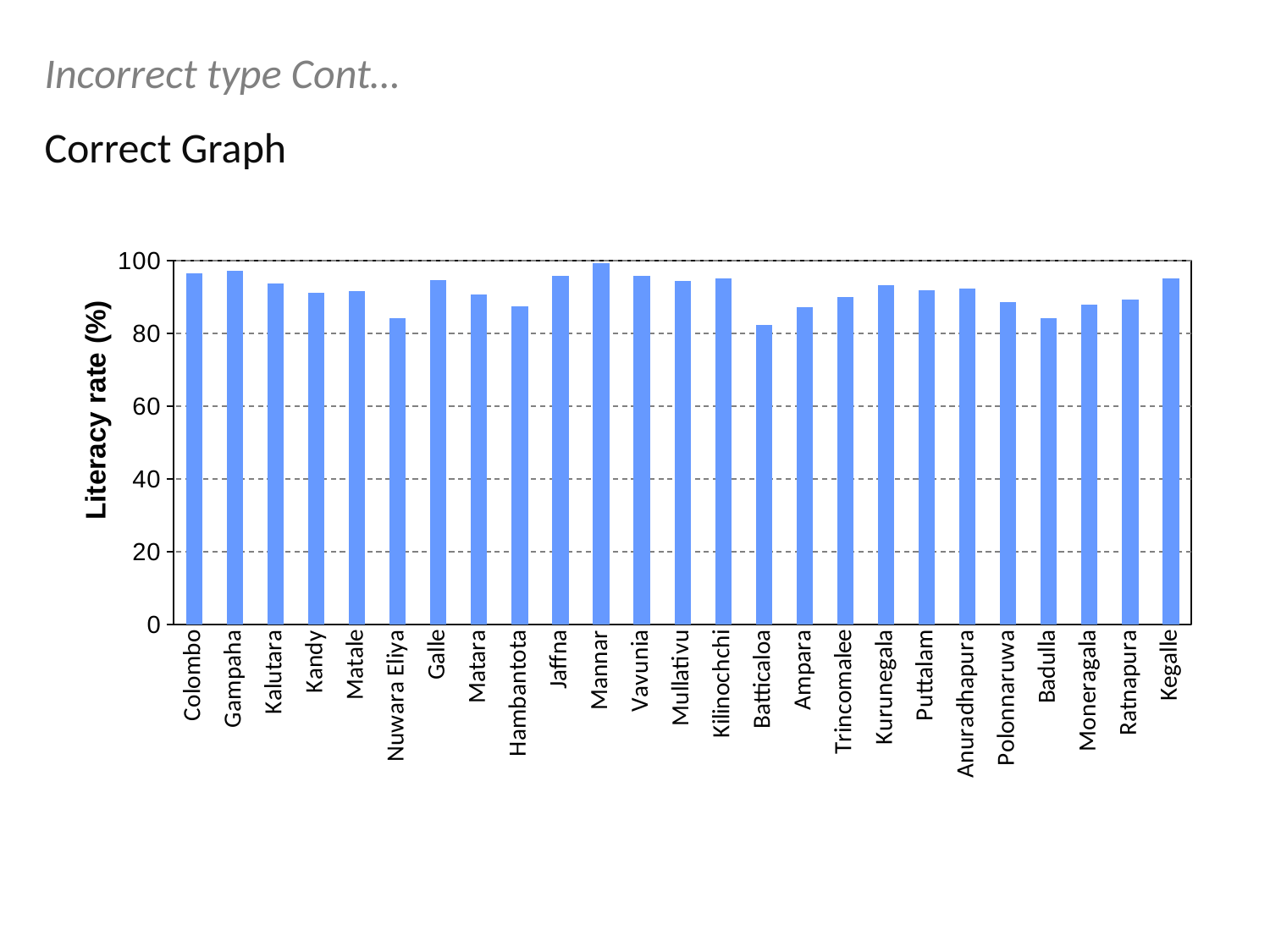
Which has a higher literacy rate, Mannar or Batticaloa? Mannar Is the literacy rate for Nuwara Eliya greater or less than 100? less Which district has the lowest literacy rate? Batticaloa How many districts (categories) are plotted on the x axis? 25 Which district has the highest literacy rate? Mannar Is the literacy rate for Kandy greater or less than 60? greater Is the literacy rate for Batticaloa greater or less than 80? greater What is the label on the y axis? Literacy rate (%) What kind of chart is shown on the slide? bar chart Which has a higher literacy rate, Jaffna or Hambantota? Jaffna What is the highest value shown on the y axis? 100 Which has a higher literacy rate, Gampaha or Kandy? Gampaha